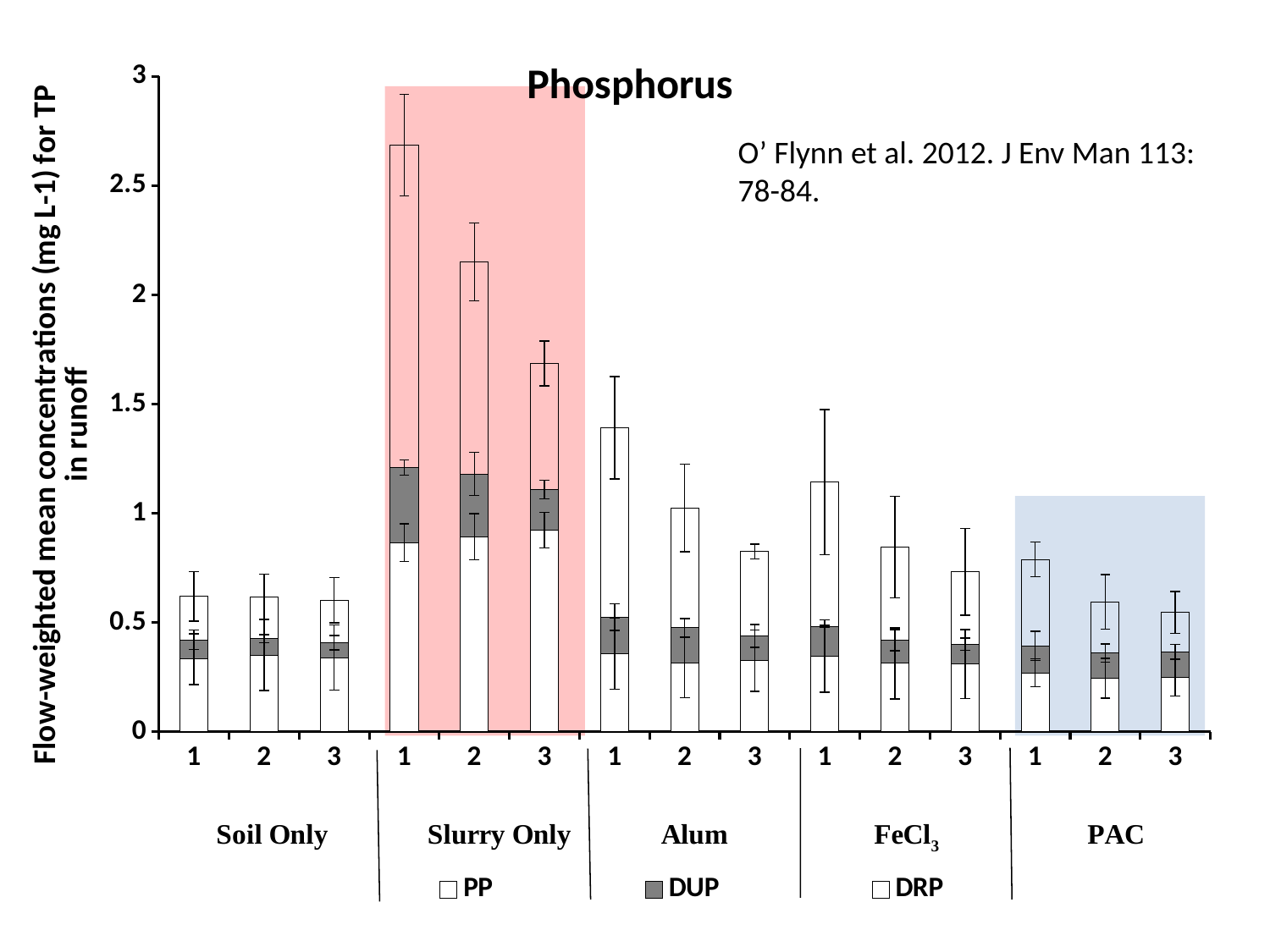
How many bars are plotted in total across all groups? 15 How many treatment groups are shown along the x axis? 5 Is the total for Slurry Only bar 2 greater or less than 2? greater Is the total for Slurry Only bar 1 greater or less than 2.5? greater Within the Slurry Only group, do the bar totals rise or fall from bar 1 to bar 3? fall Which has the larger total: Alum bar 2 or PAC bar 2? Alum bar 2 Which bar reaches the highest total concentration? Slurry Only, bar 1 Is the total for Alum bar 3 greater or less than 1? less What kind of chart is shown on the slide? stacked bar chart How many series does the legend list? 3 What is the title of the chart? Phosphorus